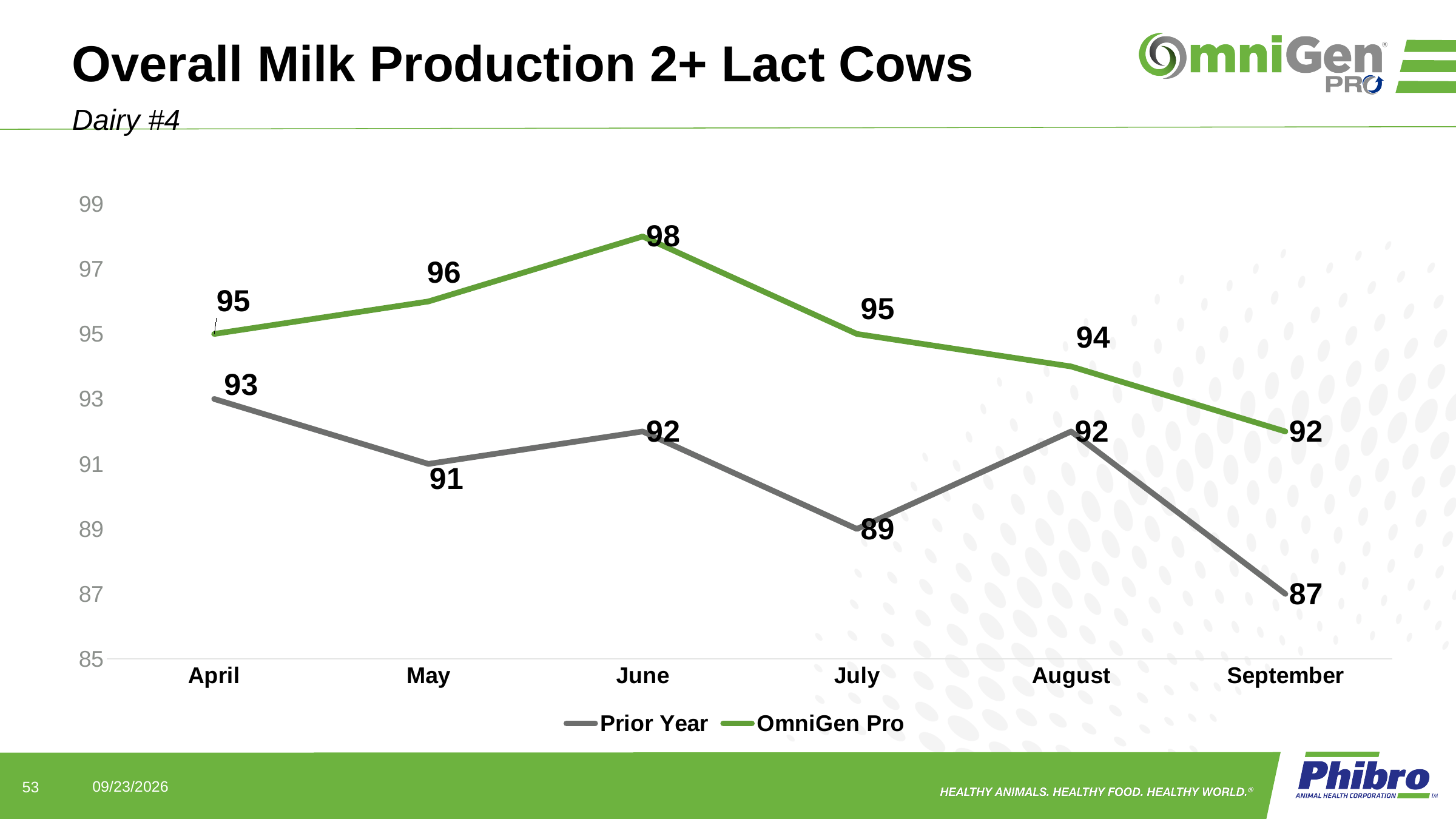
How many months are shown on the x axis? 6 What is the Prior Year value for July? 89 In which month is the OmniGen Pro value highest? June In which month is the Prior Year value lowest? September What is the difference between the OmniGen Pro and Prior Year values in July? 6 What is the difference between the OmniGen Pro and Prior Year values in September? 5 What is the OmniGen Pro value for June? 98 How many series does the legend list? 2 Which series has the larger value in August, Prior Year or OmniGen Pro? OmniGen Pro Does the OmniGen Pro line rise or fall from June to September? Fall What is the Prior Year value for September? 87 What kind of chart is shown on the slide? Line chart